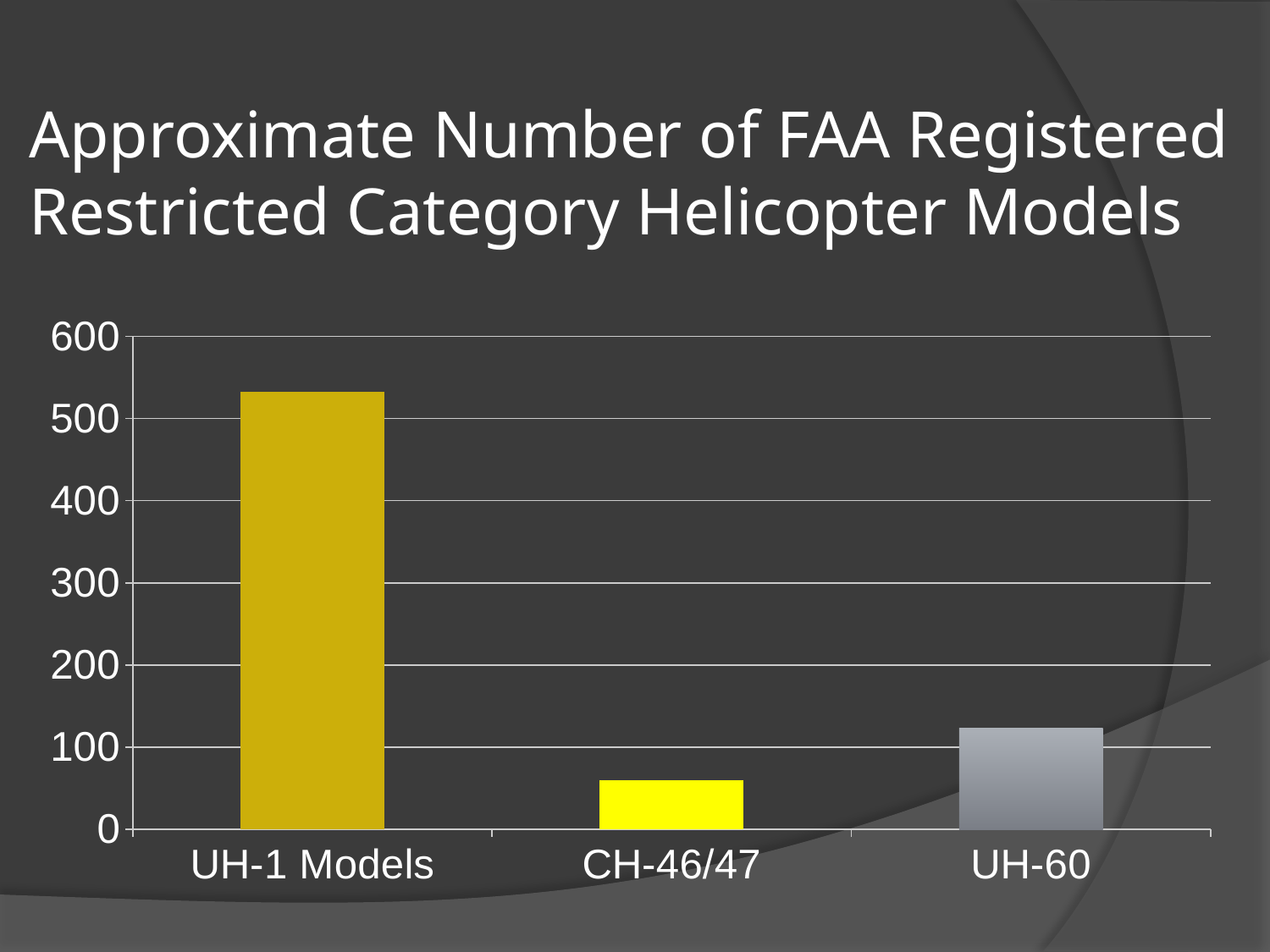
Is the value for UH-1 Models greater or less than 500? greater What is the highest value shown on the vertical axis? 600 Which is larger, the value for UH-1 Models or the value for UH-60? UH-1 Models Is the value for CH-46/47 greater or less than 100? less What kind of chart is shown on the slide? bar chart Is the value for UH-60 greater or less than 200? less Which category has the highest value? UH-1 Models Which category has the lowest value? CH-46/47 What is the title of the chart on the slide? Approximate Number of FAA Registered Restricted Category Helicopter Models Which is larger, the value for UH-60 or the value for CH-46/47? UH-60 How many categories are shown on the x axis of the chart? 3